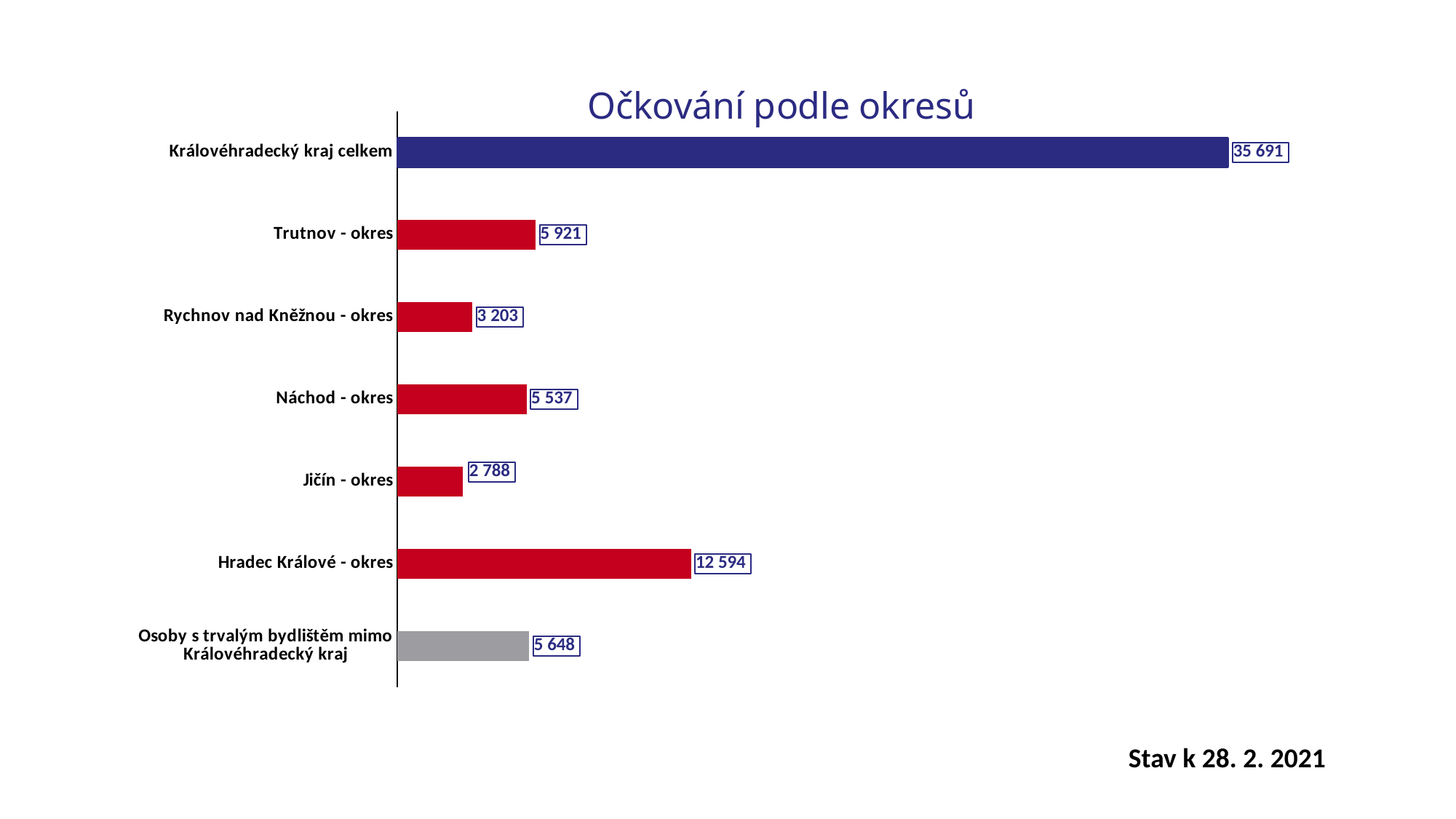
Which category has the lowest value? Jičín - okres Which is larger, the value for Náchod - okres or the value for Rychnov nad Kněžnou - okres? Náchod - okres Which category has the highest value? Královéhradecký kraj celkem How many categories are shown in the chart? 7 What is the value for Královéhradecký kraj celkem? 35 691 What kind of chart is shown on the slide? Bar chart What is the difference between the values for Hradec Králové - okres and Jičín - okres? 9 806 Which of the okres (district) categories has the highest value? Hradec Králové - okres What is the difference between the values for Trutnov - okres and Rychnov nad Kněžnou - okres? 2 718 What is the value for Trutnov - okres? 5 921 What is the value for Hradec Králové - okres? 12 594 What is the value for Osoby s trvalým bydlištěm mimo Královéhradecký kraj? 5 648